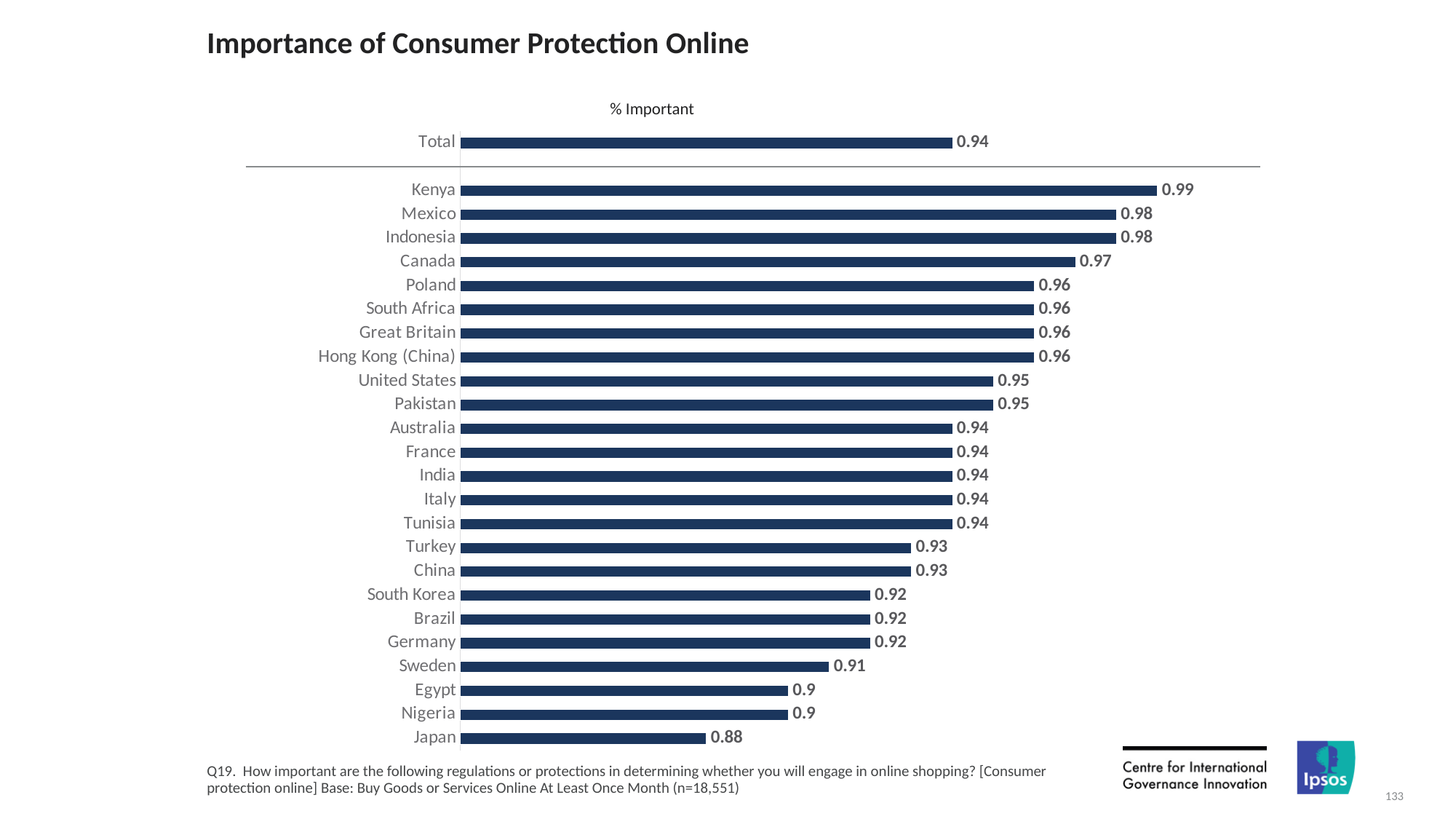
What is the difference between the values for Kenya and Japan? 0.11 What kind of chart is shown on the slide? Bar chart What is the difference between the values for Canada and Germany? 0.05 Which country has the lowest value? Japan Which country has the highest value? Kenya What is the value for Japan? 0.88 What is the value for Kenya? 0.99 How many countries are listed below the Total bar? 24 Which is larger, the value for Mexico or the value for Turkey? Mexico What is the title of the chart? % Important What is the value for Sweden? 0.91 What is the value for Total? 0.94